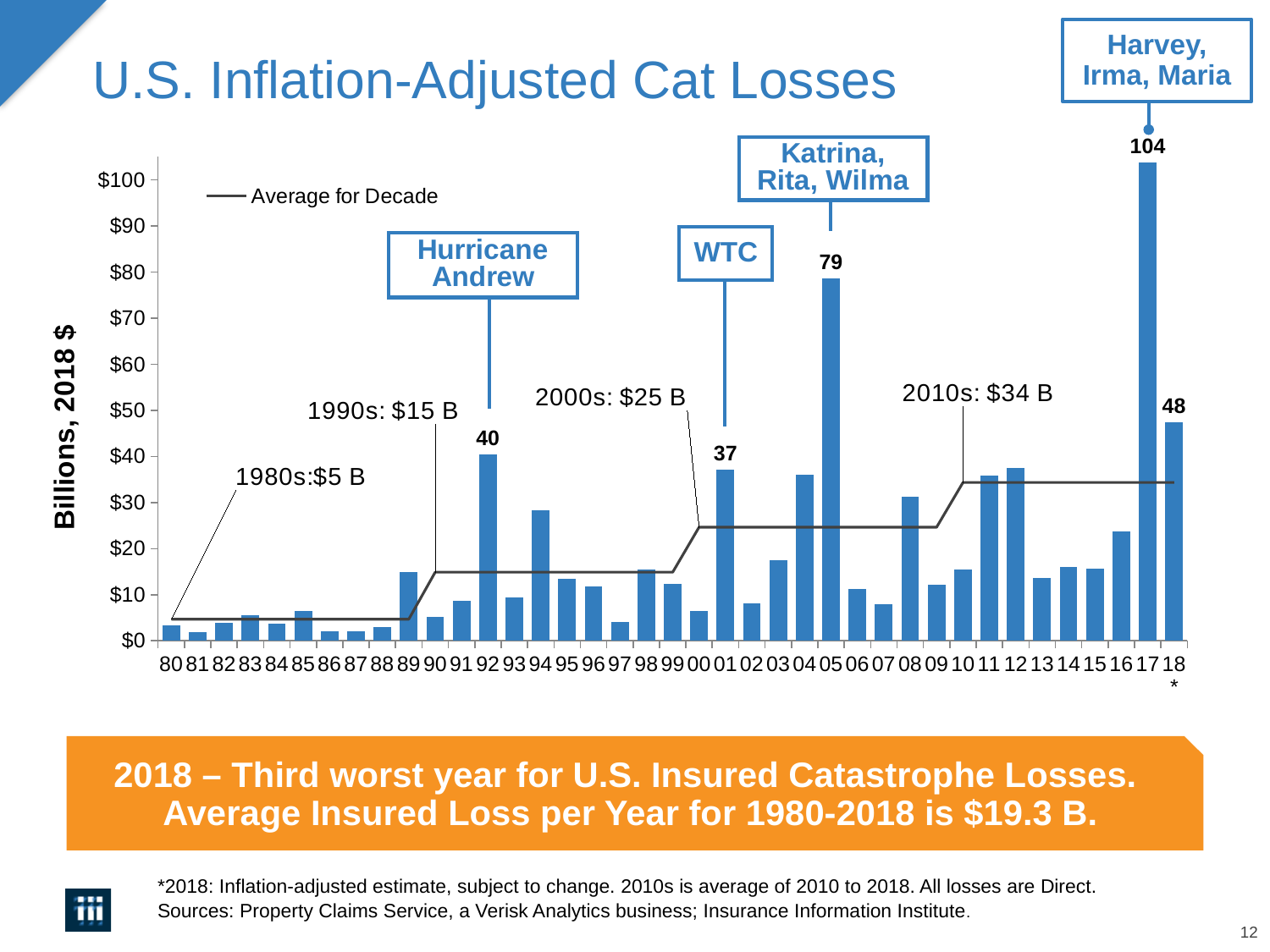
Is the value for 2004 greater or less than $30? greater What is the average for the 2010s decade shown on the chart? $34 B What is the value for 2018 in the chart? 48 Which year has the highest cat losses in the chart? 2017 Is the value for 1997 greater or less than $10? less What is the value for 1992 in the chart? 40 What type of chart is shown on the slide? bar chart How many years (bars) are plotted in the chart? 39 What is the difference between the 2017 value and the 2005 value? 25 Which is larger, the value for 2001 or the value for 1992? 1992 What is the value for 2005 in the chart? 79 What is the value for 2017 in the U.S. Inflation-Adjusted Cat Losses chart? 104